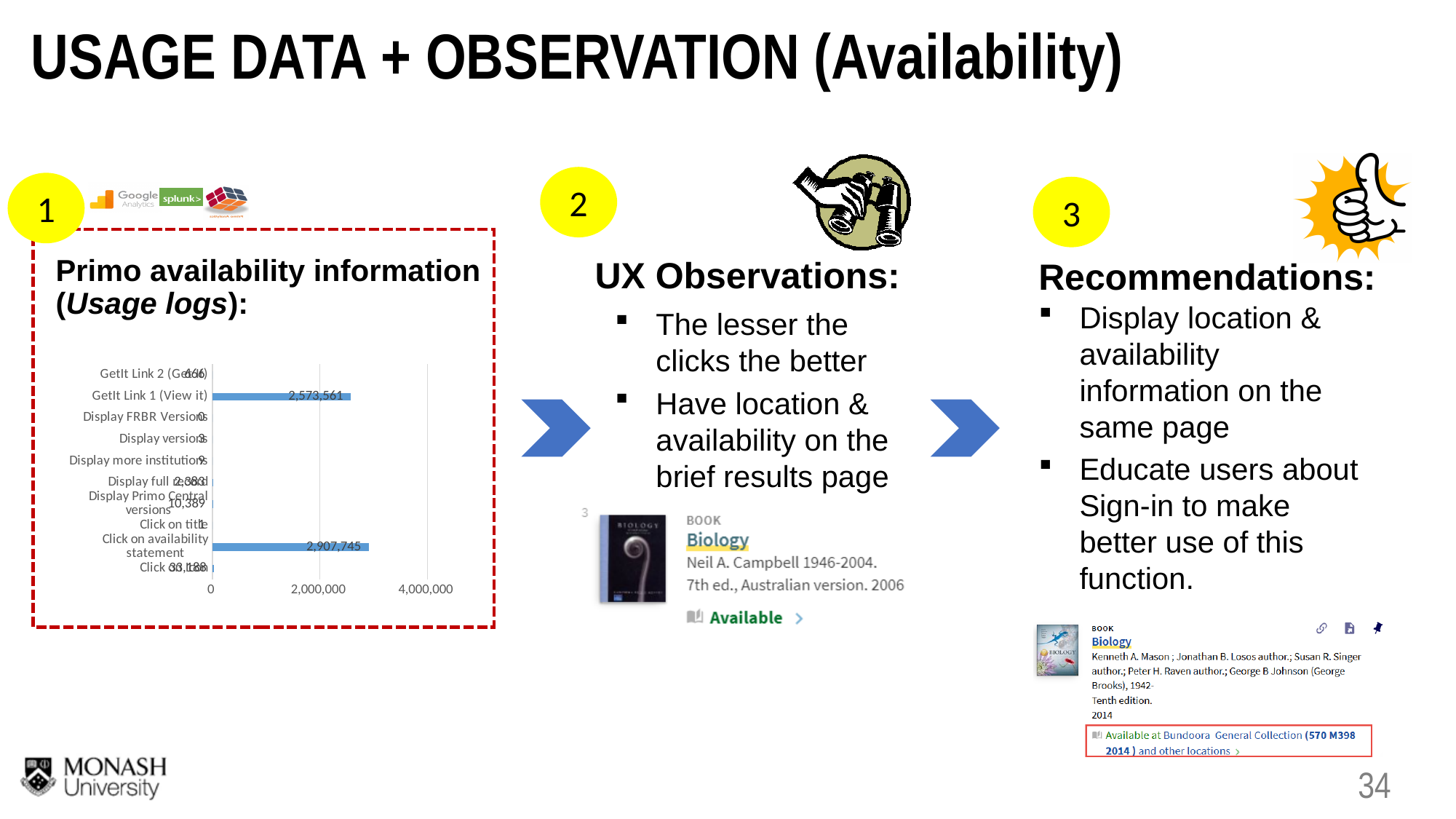
Is the value for 'GetIt Link 1 (View it)' greater or less than 2,000,000? greater Is the value for 'Display Primo Central versions' greater or less than 2,000,000? less What is the value for 'GetIt Link 1 (View it)' in the Primo availability information chart? 2,573,561 What kind of chart is shown under 'Primo availability information (Usage logs)'? Bar chart What is the value for 'Display Primo Central versions' in the Primo availability information chart? 10,389 Is the value for 'Click on availability statement' greater or less than 4,000,000? less What is the value for 'Click on availability statement' in the Primo availability information chart? 2,907,745 Which is larger in the Primo availability information chart: 'Click on availability statement' or 'GetIt Link 1 (View it)'? Click on availability statement How many categories are shown in the Primo availability information chart? 10 What is the difference between 'Click on availability statement' and 'GetIt Link 1 (View it)' in the Primo availability information chart? 334,184 What is the highest tick value shown on the horizontal axis of the Primo availability information chart? 4,000,000 Which category has the highest value in the Primo availability information chart? Click on availability statement